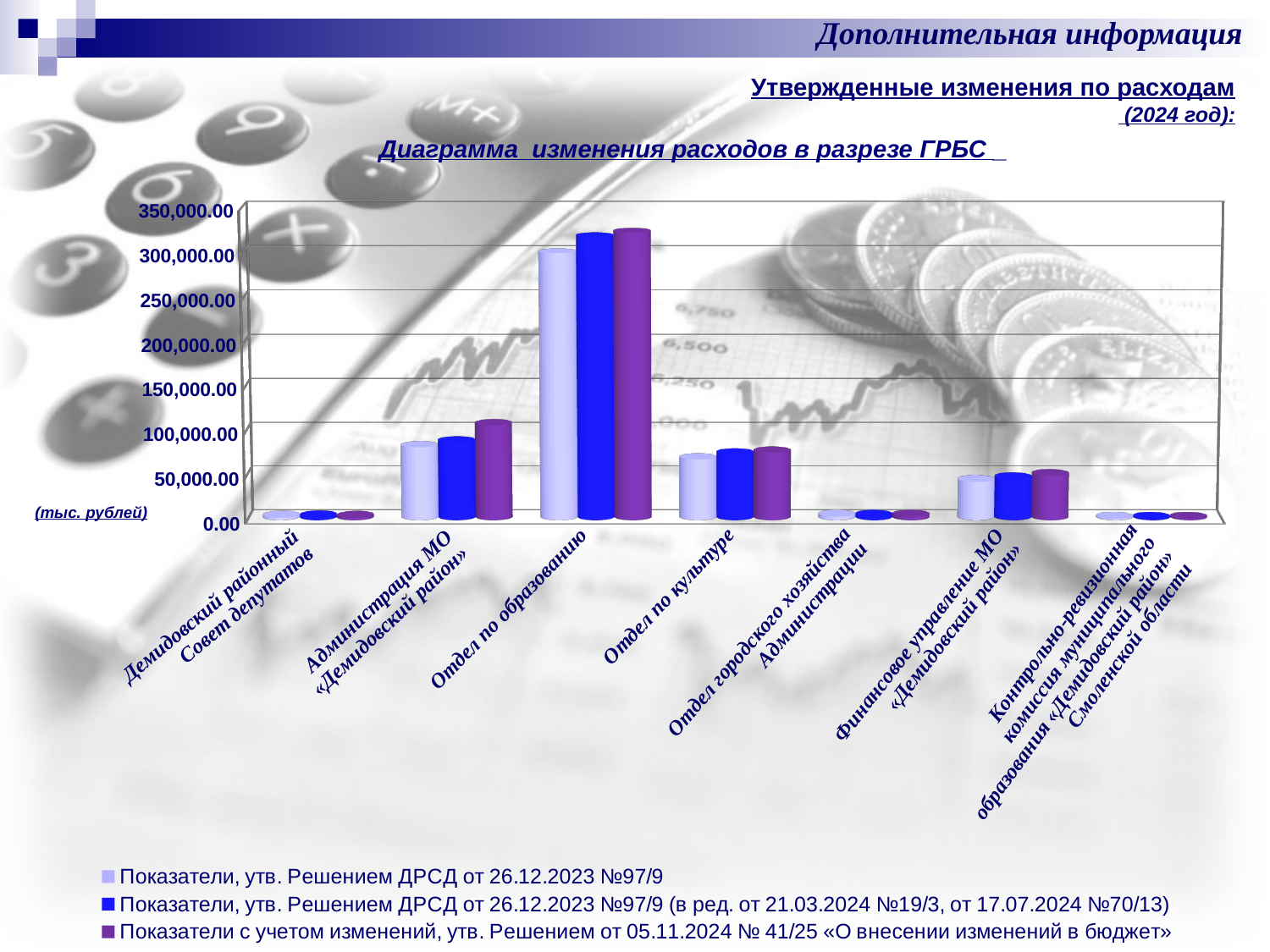
What kind of chart is shown on the slide? bar chart Which has the larger value in the series «Показатели с учетом изменений, утв. Решением от 05.11.2024 № 41/25»: Администрация МО «Демидовский район» or Финансовое управление МО «Демидовский район»? Администрация МО «Демидовский район» Is the value for Финансовое управление МО «Демидовский район» in the series «Показатели с учетом изменений, утв. Решением от 05.11.2024 № 41/25» greater or less than 100,000.00? less Is the value for Отдел по образованию in the series «Показатели с учетом изменений, утв. Решением от 05.11.2024 № 41/25» greater or less than 250,000.00? greater Is the value for Отдел по культуре in the series «Показатели, утв. Решением ДРСД от 26.12.2023 №97/9» greater or less than 50,000.00? greater Which has the larger value in the series «Показатели, утв. Решением ДРСД от 26.12.2023 №97/9»: Отдел по образованию or Отдел по культуре? Отдел по образованию Which category has the highest values in the chart? Отдел по образованию What is the title of the chart? Диаграмма изменения расходов в разрезе ГРБС How many categories (ГРБС) are shown along the x axis of the chart? 7 How many series does the chart legend list? 3 In what units are the chart values given, according to the label next to the vertical axis? тыс. рублей